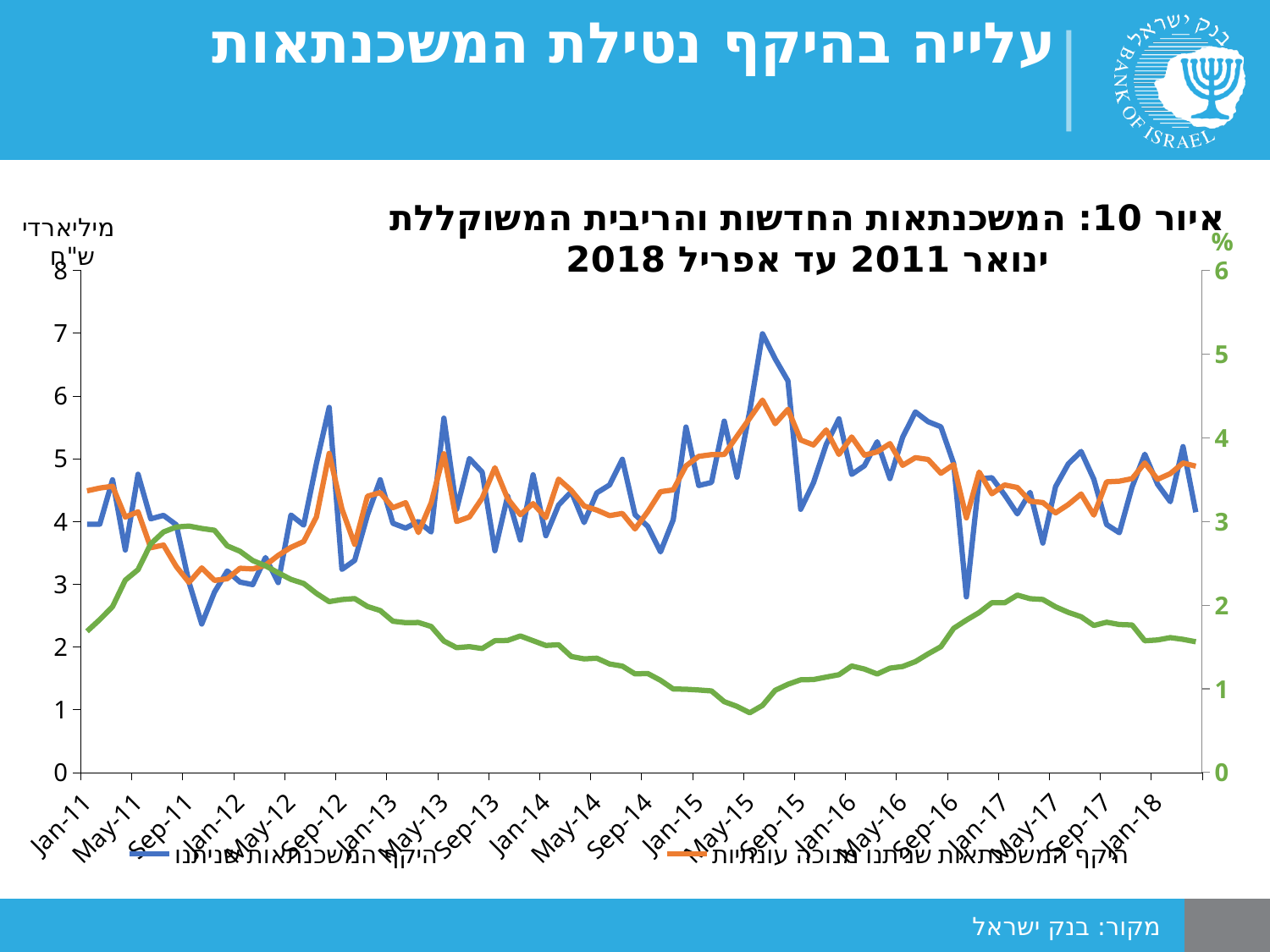
What unit is shown on the left vertical axis of the chart? מיליארדי ש"ח Is the value of the green line at Sep-11 greater or less than 2? greater Is the blue line higher at May-15 or at Jan-11? May-15 Is the peak value of the blue line (around May-15) greater or less than 6 on the left axis? greater Which line reaches the highest point on the chart: the blue line or the green line? the blue line Which series does the blue line represent according to the legend? היקף המשכנתאות שניתנו Is the lowest point of the green line (around May-15) greater or less than 1? less How many lines are plotted on the chart? 3 Does the green line rise or fall between Sep-11 and May-15? fall What is the title of the chart? איור 10: המשכנתאות החדשות והריבית המשוקללת ינואר 2011 עד אפריל 2018 What kind of chart is shown on the slide? line chart